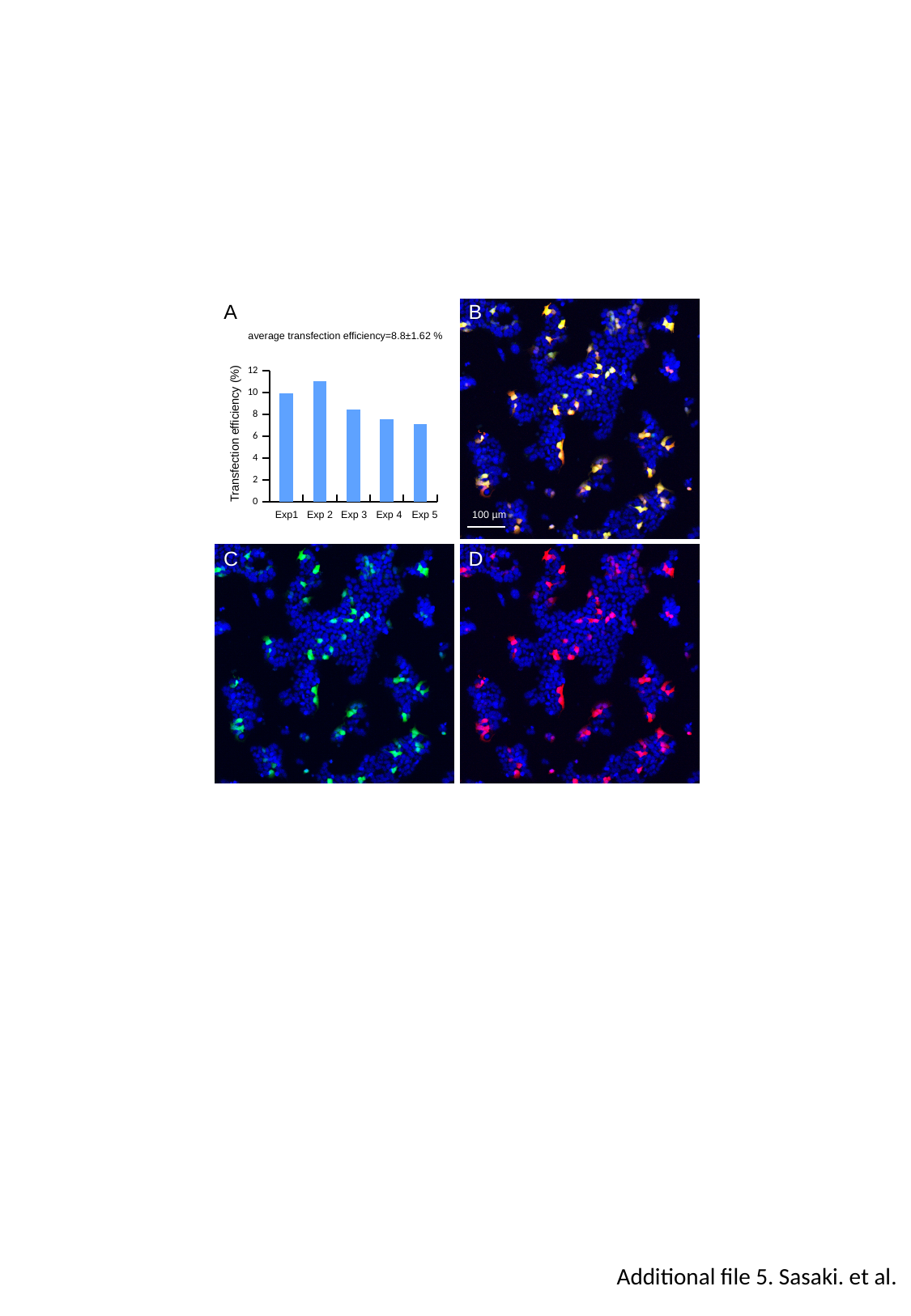
In the panel A chart, which experiment has the lowest transfection efficiency? Exp 5 In the panel A chart, is the value for Exp 4 greater or less than 6? greater In the panel A chart, is the value for Exp 2 greater or less than 10? greater What is the y-axis label of the panel A chart? Transfection efficiency (%) In the panel A chart, is the value for Exp 5 greater or less than 8? less In the panel A chart, do the values rise or fall from Exp 2 to Exp 5? fall What average transfection efficiency is stated above the panel A chart? 8.8±1.62 % In the panel A chart, which experiment has the highest transfection efficiency? Exp 2 In the panel A chart, which has the higher transfection efficiency, Exp 3 or Exp 2? Exp 2 How many experiments (bars) are plotted in the panel A chart? 5 In the panel A chart, which has the higher transfection efficiency, Exp1 or Exp 4? Exp1 What kind of chart is shown in panel A? bar chart